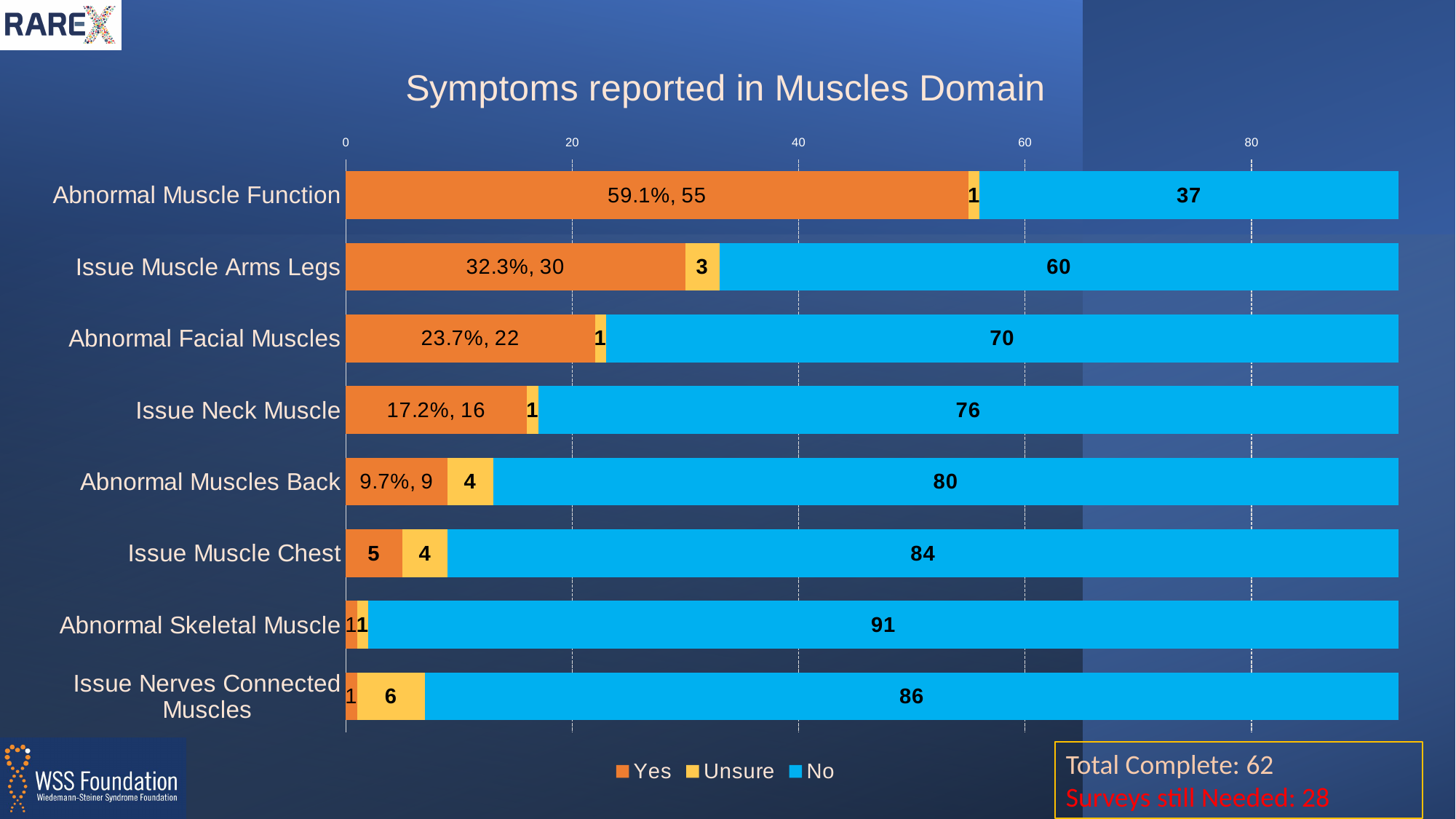
What is the 'Yes' value for Issue Muscle Arms Legs? 30 What is the 'Unsure' value for Issue Nerves Connected Muscles? 6 How many symptom categories are plotted in the chart? 8 What is the total of the stacked bar for Issue Muscle Chest? 93 Which symptom has the highest 'No' value? Abnormal Skeletal Muscle Which is larger: the 'Unsure' value for Abnormal Muscles Back or for Issue Muscle Arms Legs? Abnormal Muscles Back What percentage is shown for 'Yes' on Abnormal Facial Muscles? 23.7% What type of chart is shown on the slide? Stacked bar chart What is the difference between the 'No' values for Issue Muscle Chest and Issue Neck Muscle? 8 How many series does the legend list? 3 Which symptom has the highest 'Yes' value? Abnormal Muscle Function What is the 'No' value for Abnormal Muscle Function? 37